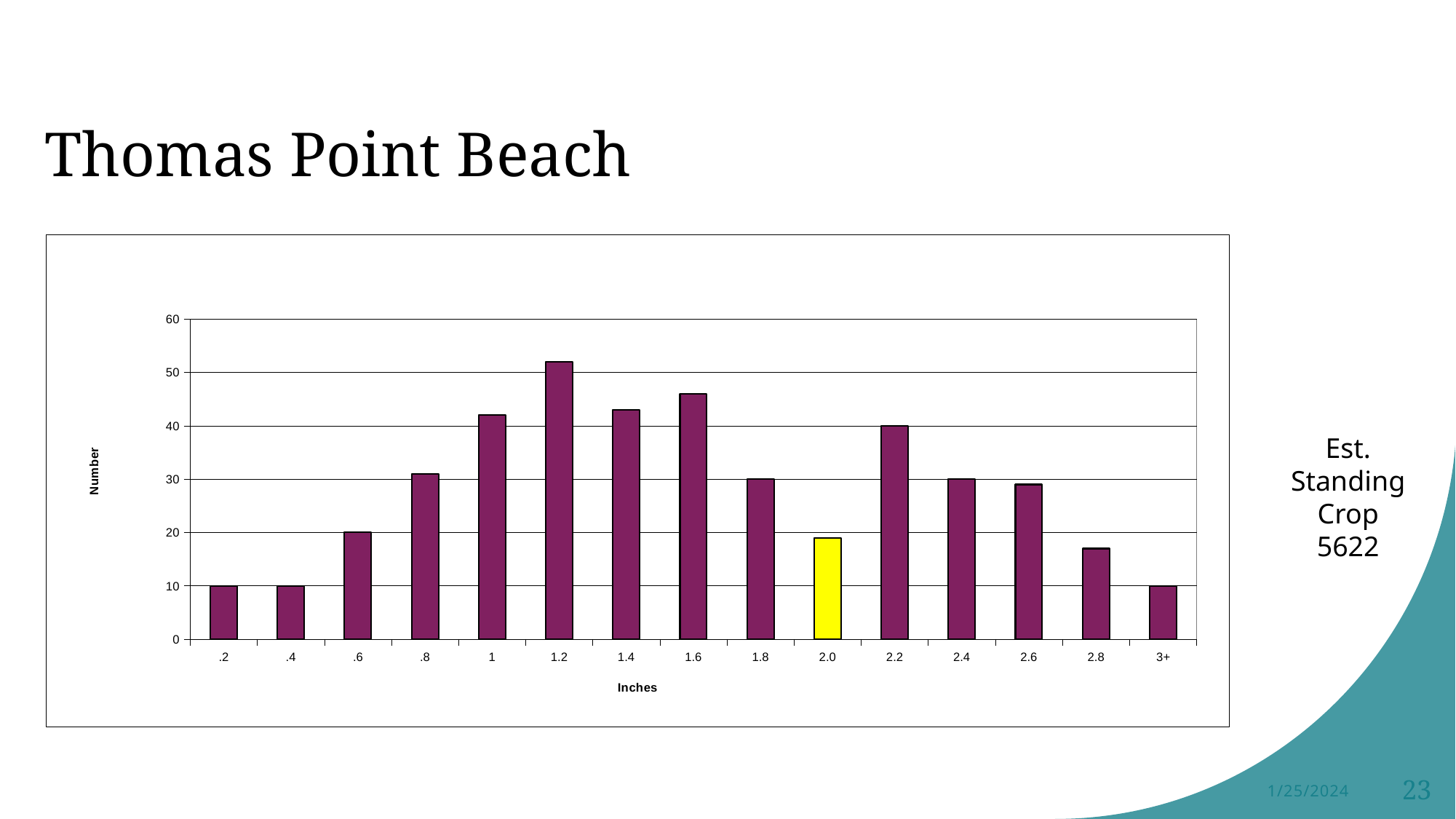
Which inch category has the highest number? 1.2 Which inch category is shown with a yellow bar? 2.0 How many categories are shown on the x axis of the chart? 15 What is the number for the .6 inch category? 20 What kind of chart is shown on the slide? bar chart What is the difference between the number for the 2.2 inch category and the 1.8 inch category? 10 Which has a larger number, the 2.2 inch category or the 2.6 inch category? 2.2 Is the value for the 1.2 inch category greater or less than 50? greater Is the value for the 1.6 inch category greater or less than 40? greater What is the number for the 1.8 inch category? 30 What is the number for the 2.2 inch category? 40